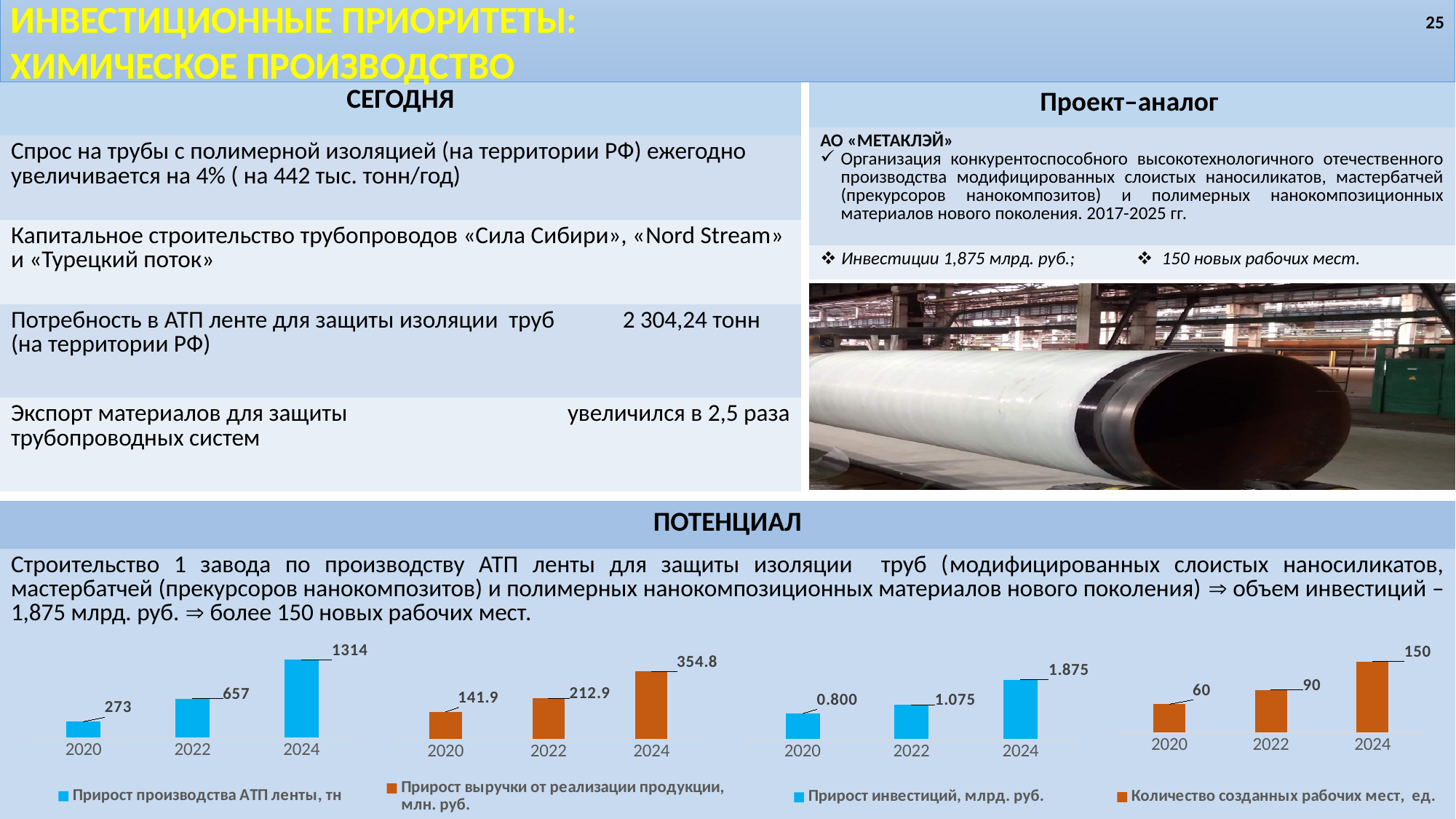
In the chart 'Количество созданных рабочих мест, ед.' (rightmost chart), do the values rise or fall from 2020 to 2024? rise How many bars are shown in the chart 'Прирост инвестиций, млрд. руб.' (third chart from the left)? 3 What type of chart is used for 'Прирост выручки от реализации продукции, млн. руб.' (second chart from the left)? bar chart In the chart 'Прирост производства АТП ленты, тн' (leftmost chart), what is the value for 2020? 273 In the chart 'Прирост производства АТП ленты, тн' (leftmost chart), what is the value for 2024? 1314 In the chart 'Прирост инвестиций, млрд. руб.' (third chart from the left), which year has the lowest value? 2020 In the chart 'Прирост инвестиций, млрд. руб.' (third chart from the left), what is the value for 2024? 1.875 In the chart 'Прирост выручки от реализации продукции, млн. руб.' (second chart from the left), what is the difference between the 2024 and 2020 values? 212.9 In the chart 'Прирост производства АТП ленты, тн' (leftmost chart), what is the difference between the 2024 and 2022 values? 657 In the chart 'Количество созданных рабочих мест, ед.' (rightmost chart), what is the value for 2022? 90 In the chart 'Количество созданных рабочих мест, ед.' (rightmost chart), which year has the highest value? 2024 In the chart 'Прирост выручки от реализации продукции, млн. руб.' (second chart from the left), what is the value for 2022? 212.9